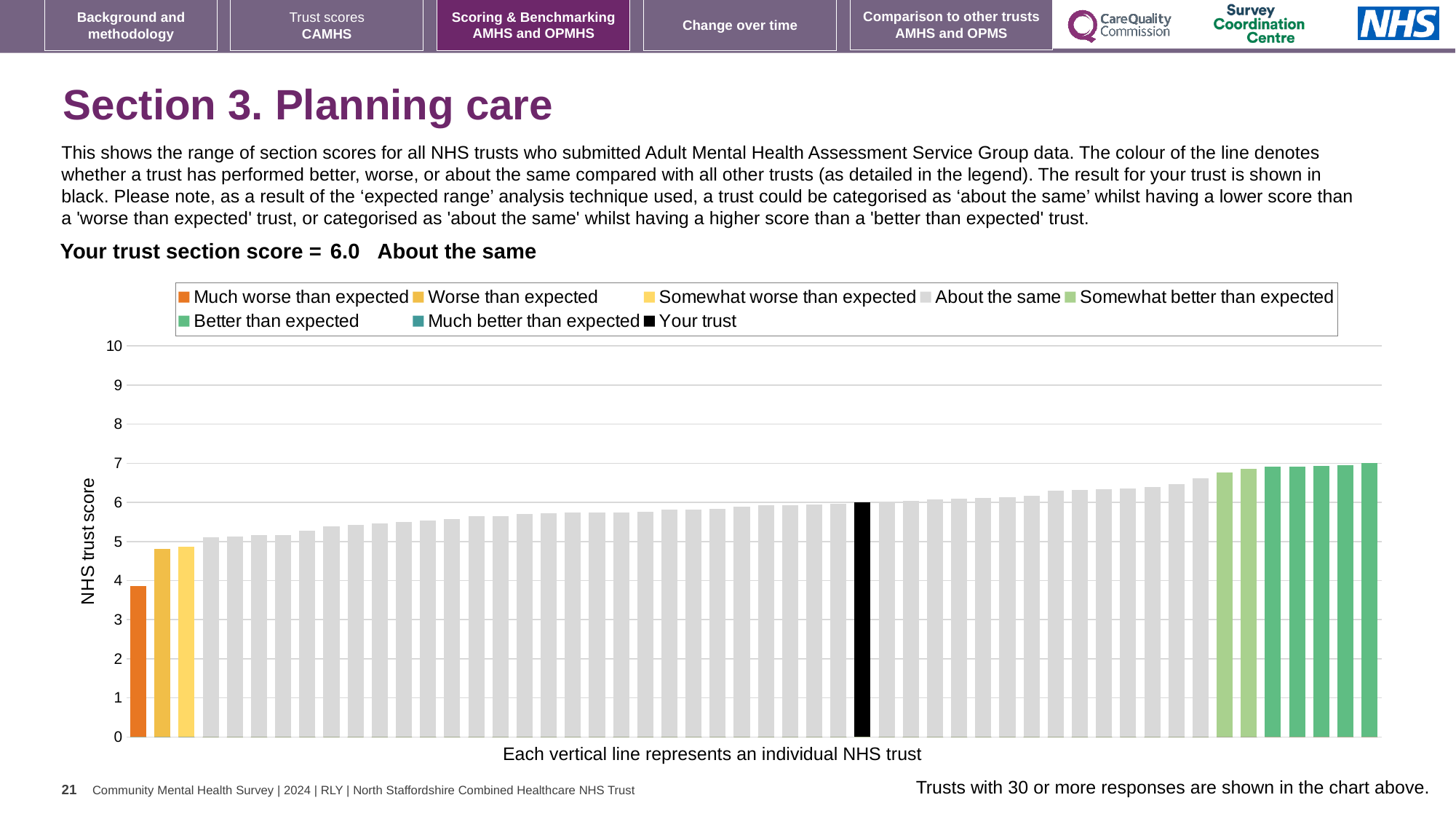
Is the value of the lowest bar (orange) greater or less than 5? less How many entries does the chart legend list? 8 Do the bar values rise or fall from left to right along the x axis? rise What kind of chart is shown on the slide? bar chart What is the label on the vertical axis of the chart? NHS trust score How many bars are coloured orange (Much worse than expected)? 1 How many bars are coloured dark green (Better than expected)? 5 Which category is your trust placed in for this section? About the same Which legend category does the lowest bar belong to? Much worse than expected What is the section score for your trust? 6.0 Is the value of the highest bar greater or less than 8? less Is the value for your trust (black bar) greater or less than 5? greater